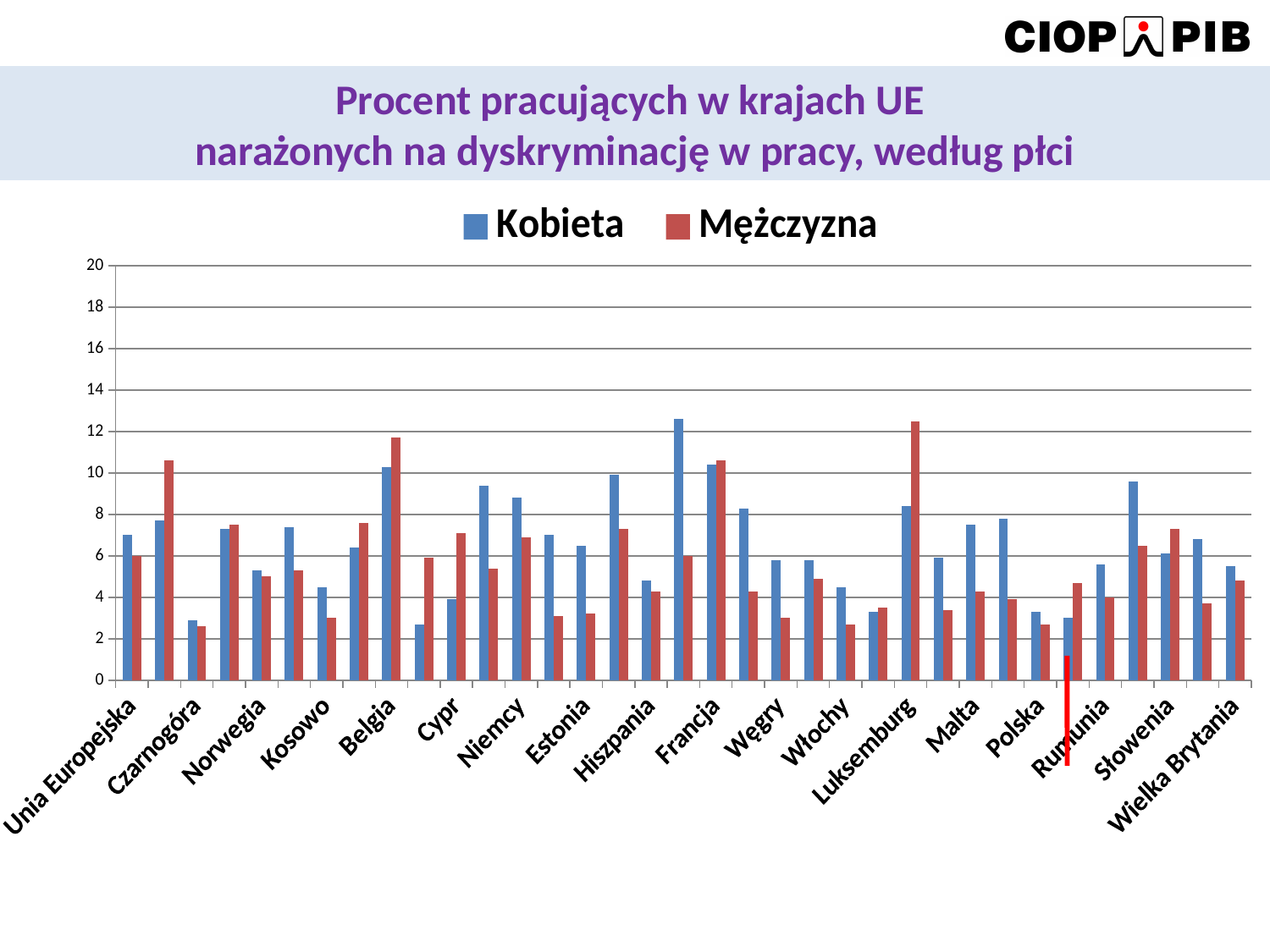
For Belgia, which is larger: the Kobieta value or the Mężczyzna value? Mężczyzna What kind of chart is shown on the slide? bar chart Which series is shown in red? Mężczyzna What are the two series named in the legend? Kobieta and Mężczyzna Which country has the highest Mężczyzna value? Luksemburg Is the Kobieta value for Polska greater or less than 4? less Is the Kobieta value for Niemcy greater or less than 8? greater Is the Mężczyzna value for Czarnogóra greater or less than 10? less How many series does the legend list? 2 For Hiszpania, which is larger: the Kobieta value or the Mężczyzna value? Kobieta